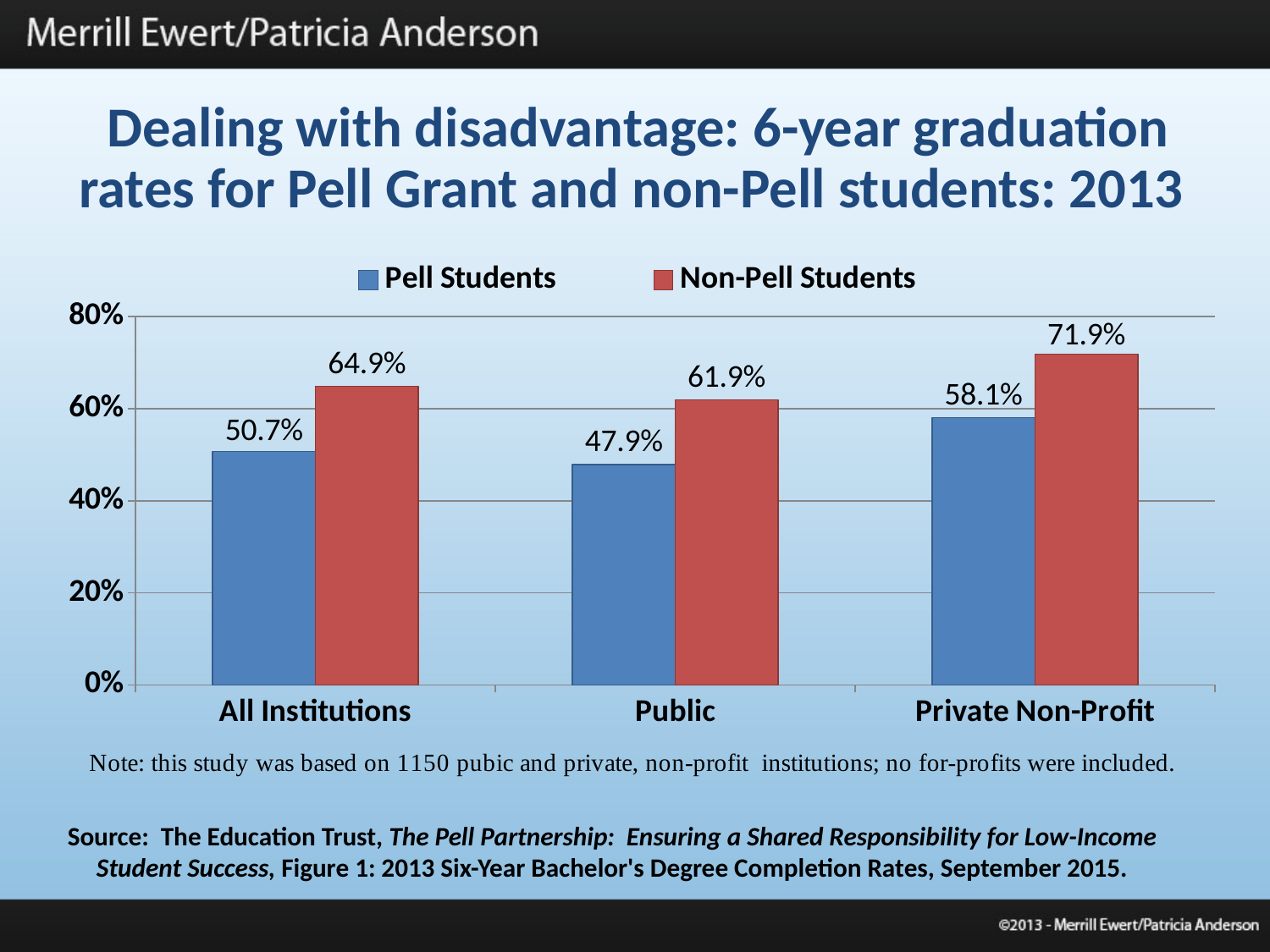
What is the graduation rate for Pell Students across All Institutions? 50.7% Which category has the lowest Pell Students graduation rate? Public What is the difference between the Non-Pell and Pell graduation rates at Private Non-Profit institutions? 13.8 percentage points What is the difference between the Non-Pell and Pell graduation rates at Public institutions? 14 percentage points How many series does the legend list? 2 Is the Pell Students graduation rate at Public institutions greater or less than 60%? less Which is larger: the Pell Students rate at Private Non-Profit institutions or the Non-Pell Students rate at All Institutions? Non-Pell Students rate at All Institutions What kind of chart is shown on the slide? Bar chart How many institution categories are shown on the x axis? 3 Which category has the highest Non-Pell Students graduation rate? Private Non-Profit What is the 6-year graduation rate for Pell Students at Public institutions? 47.9% What is the 6-year graduation rate for Non-Pell Students at Private Non-Profit institutions? 71.9%